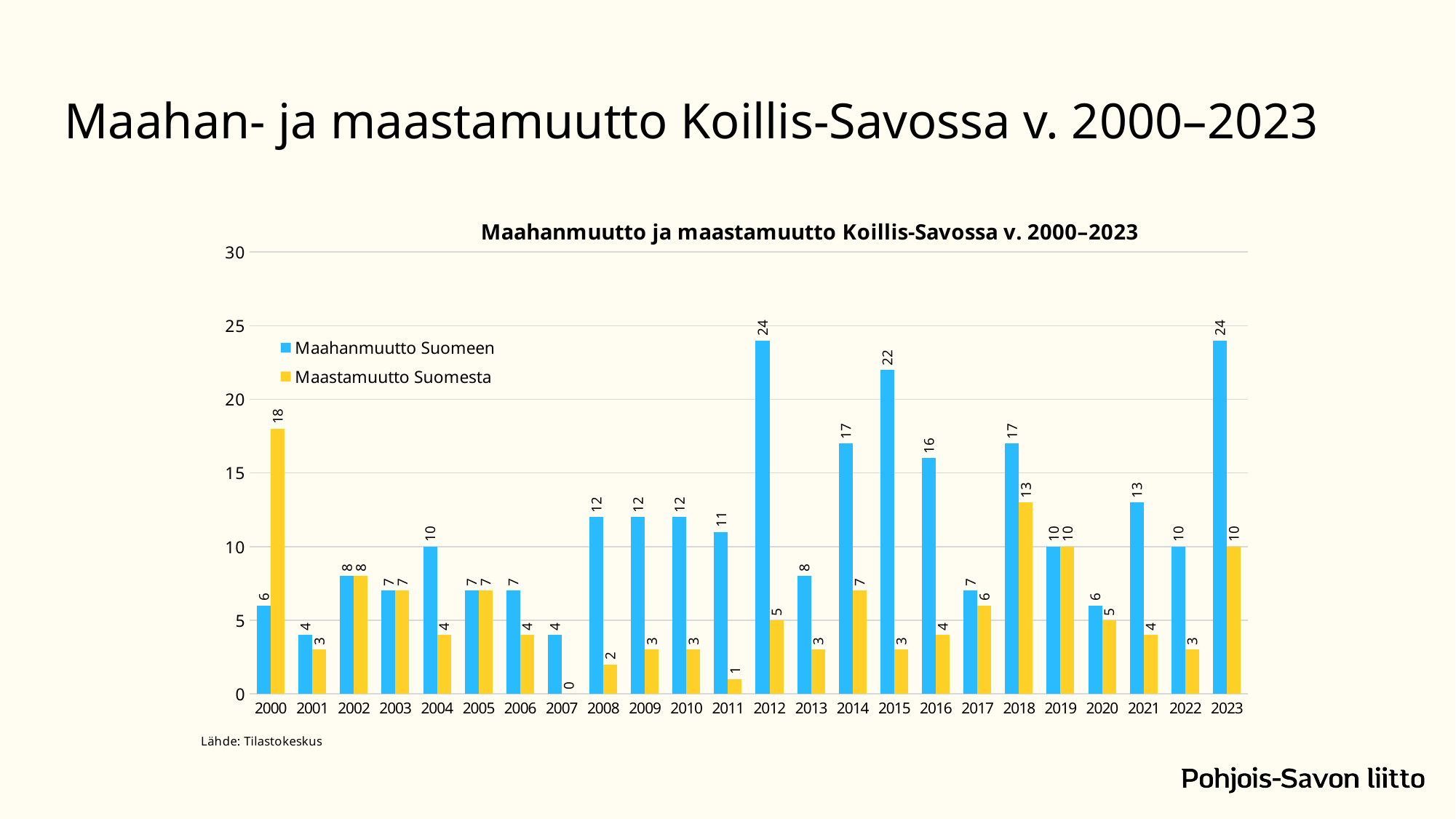
What is the value of Maastamuutto Suomesta in 2018? 13 What is the source cited below the chart? Tilastokeskus How many years are shown on the x axis? 24 What is the value of Maastamuutto Suomesta in 2000? 18 What is the value of Maahanmuutto Suomeen in 2015? 22 How many series does the legend list? 2 Which is larger in 2000, Maahanmuutto Suomeen or Maastamuutto Suomesta? Maastamuutto Suomesta What kind of chart is shown on the slide? bar chart In which year is Maastamuutto Suomesta highest? 2000 In which year is Maastamuutto Suomesta lowest? 2007 What is the difference between Maahanmuutto Suomeen and Maastamuutto Suomesta in 2012? 19 Is the value for Maahanmuutto Suomeen in 2023 greater or less than 20? greater